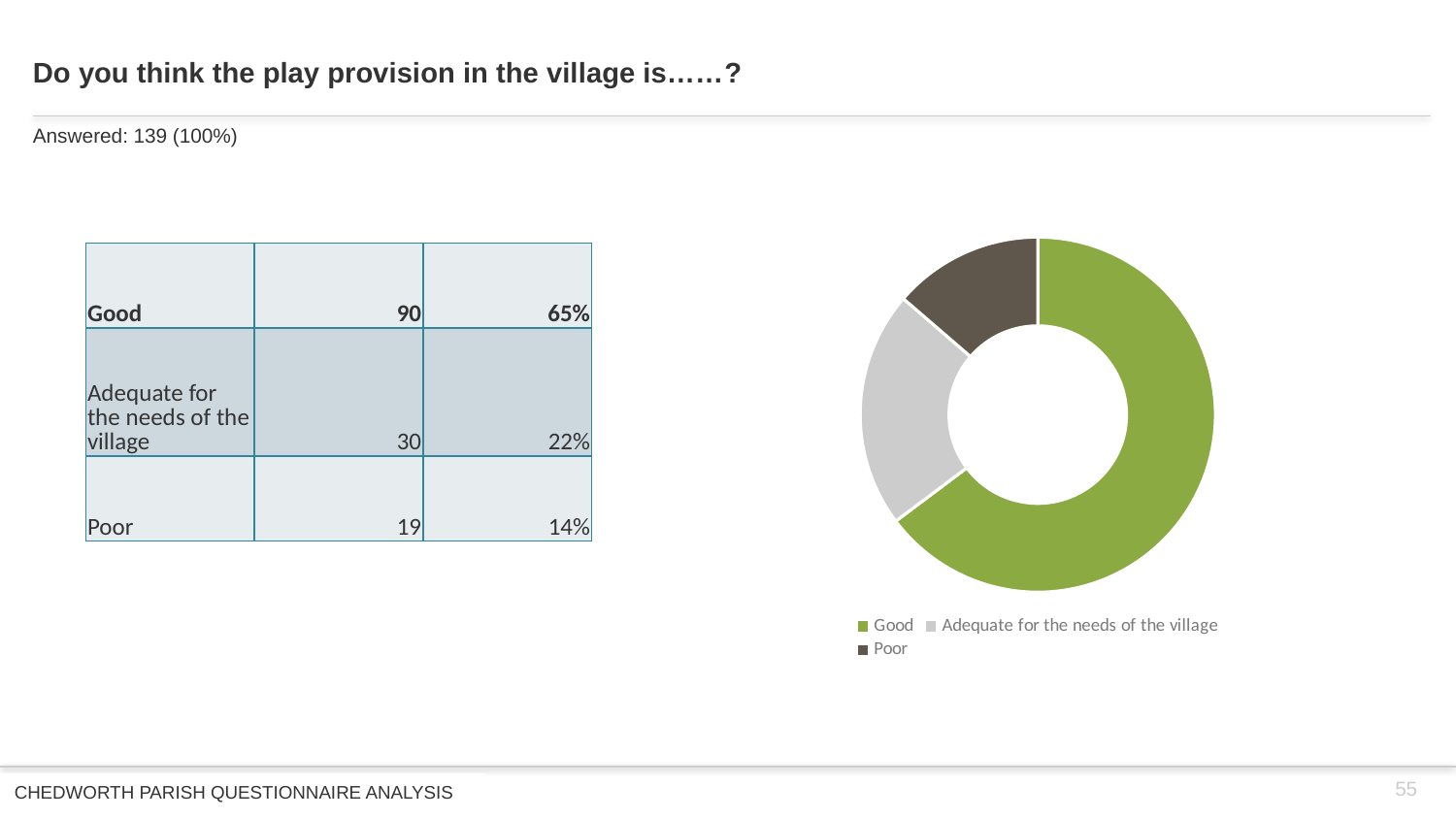
Which slice is larger, 'Adequate for the needs of the village' or Poor? Adequate for the needs of the village Which category has the largest share of the doughnut chart? Good What percentage of responses does the Good slice represent? 65% What kind of chart is shown on the slide? doughnut chart How many categories does the doughnut chart show? 3 What is the difference in responses between Good and Poor? 71 How many responses does the 'Adequate for the needs of the village' slice represent? 30 How many entries does the chart legend list? 3 How many responses does the Good slice represent? 90 What percentage of responses does the Poor slice represent? 14% Which category has the smallest share of the doughnut chart? Poor What colour is the Good slice in the doughnut chart? green